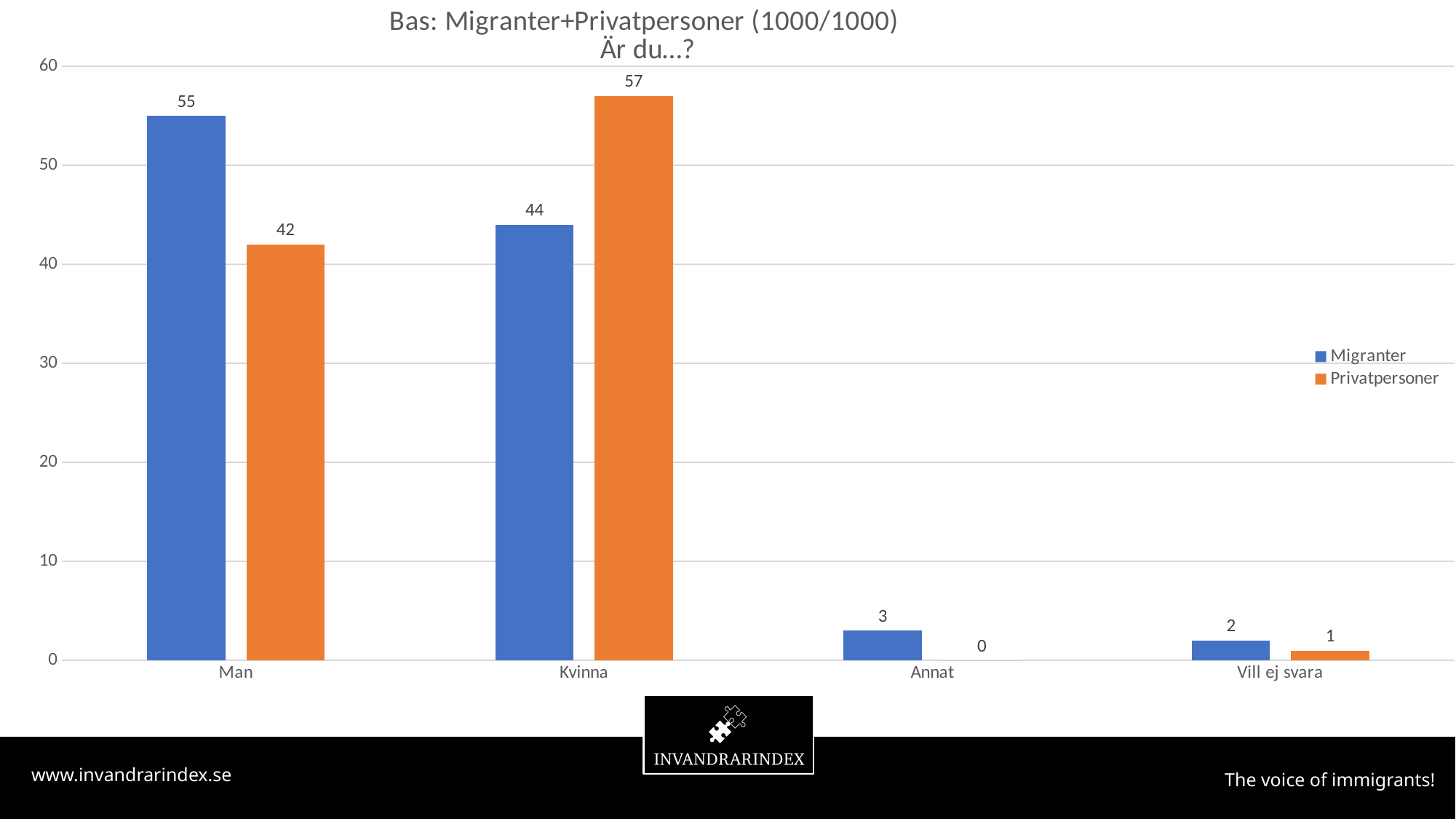
What is the value for Migranter in the Man category? 55 What is the value for Migranter in the Vill ej svara category? 2 What is the difference between the Migranter and Privatpersoner values in the Man category? 13 Which category has the lowest value for the Migranter series? Vill ej svara What is the value for Privatpersoner in the Annat category? 0 Which category has the highest value for the Privatpersoner series? Kvinna What colour represents the Privatpersoner series? Orange How many series does the legend list? 2 What kind of chart is shown on the slide? Bar chart What is the value for Privatpersoner in the Kvinna category? 57 Which is larger in the Kvinna category, Migranter or Privatpersoner? Privatpersoner How many categories are shown on the x axis? 4